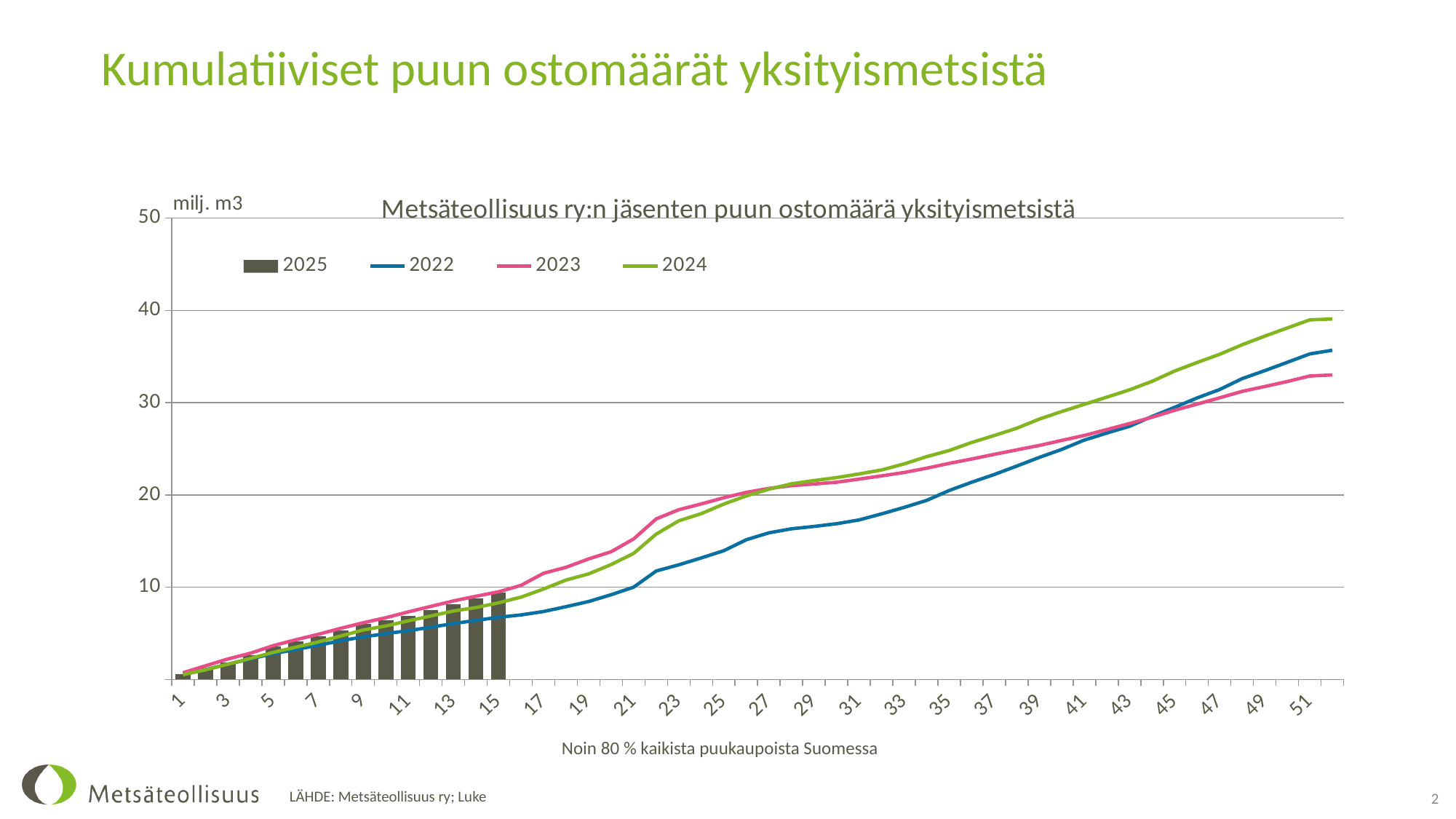
Is the value of the 2024 line at week 51 greater or less than 30? greater What is the title of the chart? Metsäteollisuus ry:n jäsenten puun ostomäärä yksityismetsistä Which series is shown as bars rather than a line? 2025 Do the values of the 2024 line rise or fall along the x axis? rise Which series has the highest value at the right end of the chart (week 52)? 2024 How many bars are plotted for the 2025 series? 15 At week 25, which is larger: the 2023 line or the 2022 line? 2023 How many series does the chart legend list? 4 Which line series has the lowest value at the right end of the chart (week 52)? 2023 Is the 2025 bar at week 15 greater or less than 10? less Is the value of the 2022 line at week 27 greater or less than 20? less